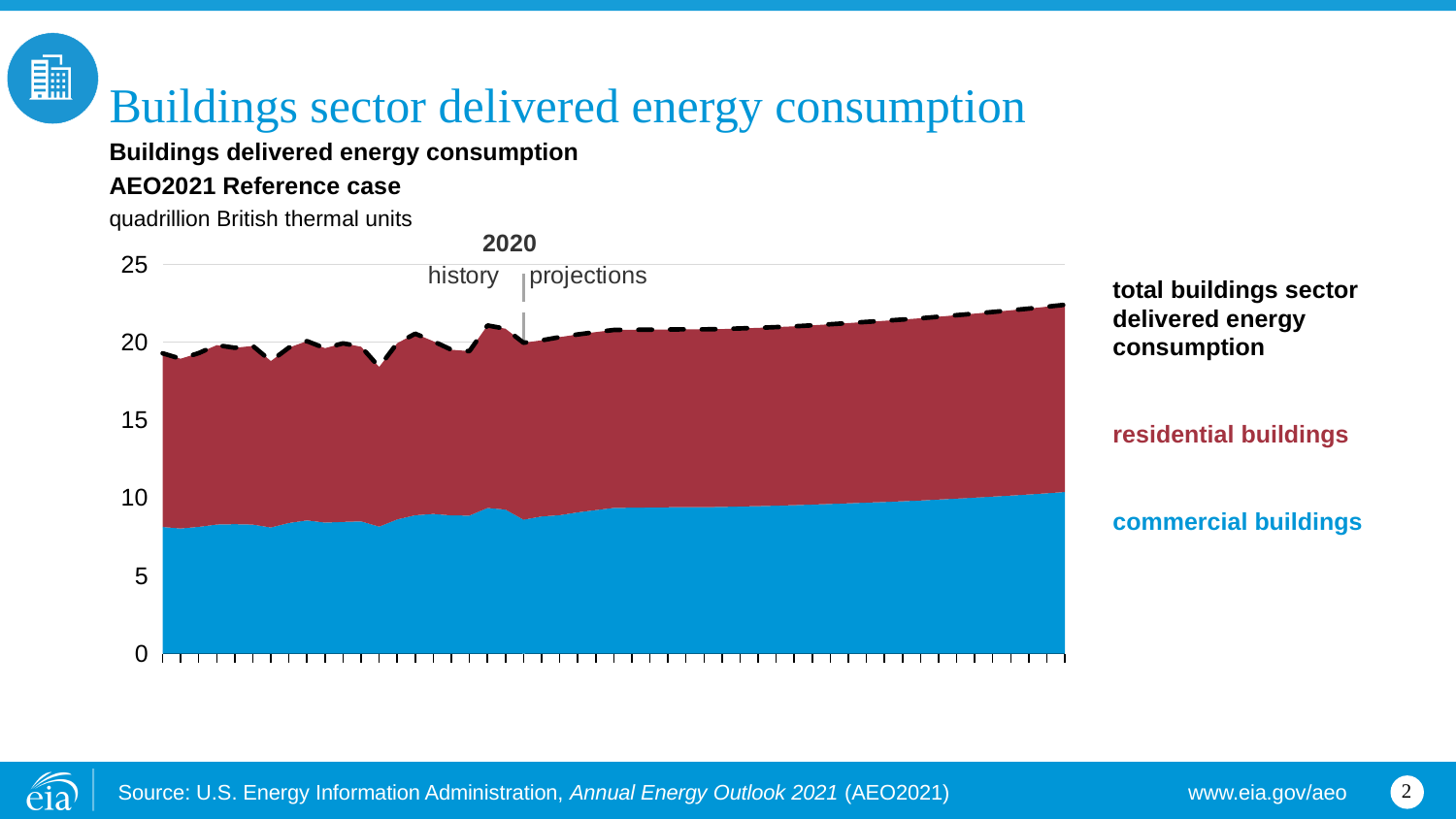
Is the total buildings sector delivered energy consumption at the end of the projection period greater or less than 25? less What kind of chart is shown on the slide? stacked area chart What is the highest value shown on the y axis of the chart? 25 How many series are labelled on the chart (including the total line)? 3 Which series is larger throughout the chart, residential buildings or commercial buildings? residential buildings Is the commercial buildings delivered energy consumption at the start of the chart greater or less than 10? less Is the commercial buildings delivered energy consumption at the start of the chart greater or less than 5? greater Does total buildings sector delivered energy consumption rise or fall over the projection period after 2020? rise What year separates history from projections in the chart? 2020 What unit is the y axis of the chart measured in? quadrillion British thermal units